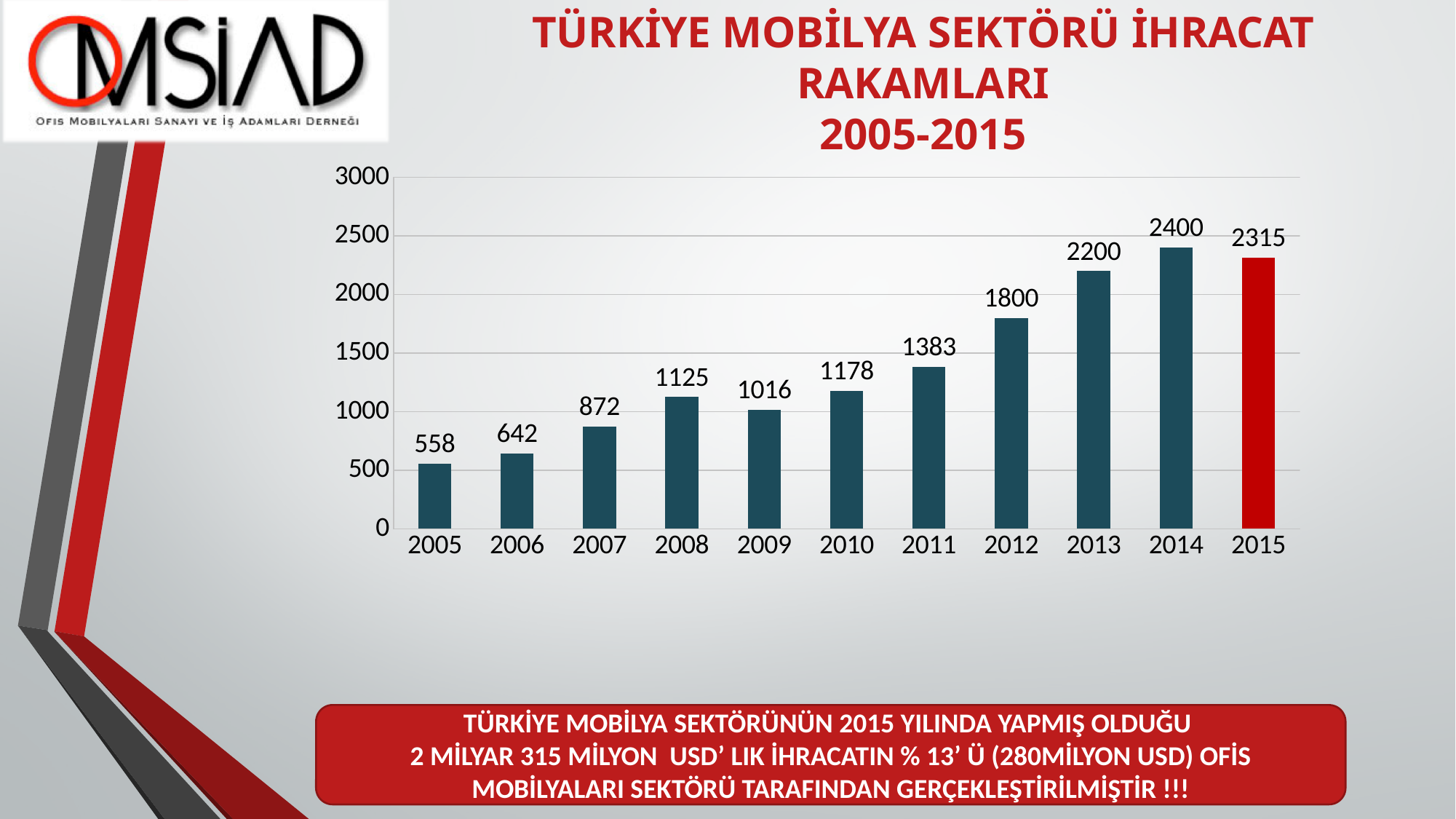
Which bar is coloured red rather than dark teal? 2015 Is the value for 2012 greater or less than 1500? greater What is the value for 2005? 558 What is the value for 2011? 1383 What is the value for 2015? 2315 Which year has the highest value? 2014 What is the difference between the values for 2008 and 2009? 109 Which year has the lowest value? 2005 What kind of chart is shown on the slide? bar chart What is the difference between the values for 2014 and 2015? 85 How many years are shown on the x axis? 11 Which is larger, the value for 2008 or the value for 2009? 2008